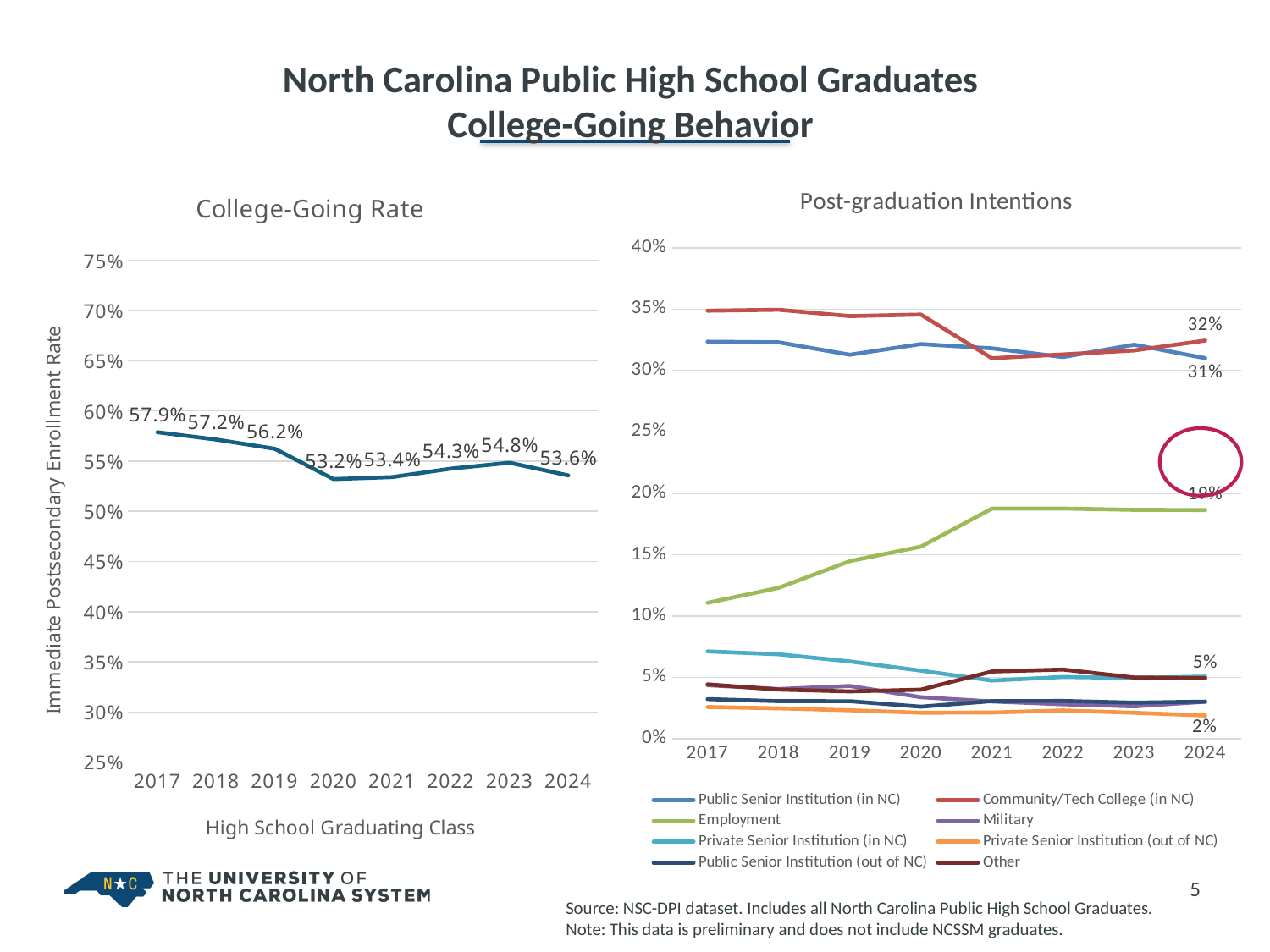
In the Post-graduation Intentions chart, how many series does the legend list? 8 In the College-Going Rate chart, what is the difference between the 2017 rate and the 2024 rate? 4.3 percentage points In the College-Going Rate chart, what was the college-going rate for the 2024 graduating class? 53.6% In the Post-graduation Intentions chart, is the Employment value for 2017 greater or less than 15%? less In the College-Going Rate chart, what was the college-going rate for the 2017 high school graduating class? 57.9% In the College-Going Rate chart, how many graduating classes are plotted? 8 In the Post-graduation Intentions chart, what percentage of 2024 graduates intended to attend a Public Senior Institution (in NC)? 31% In the College-Going Rate chart, does the college-going rate generally rise or fall from 2017 to 2024? fall In the College-Going Rate chart, which graduating class had the lowest college-going rate? 2020 What type of chart is the Post-graduation Intentions chart? line chart In the Post-graduation Intentions chart, what percentage of 2024 graduates intended to attend a Community/Tech College (in NC)? 32% In the College-Going Rate chart, which graduating class had the highest college-going rate? 2017